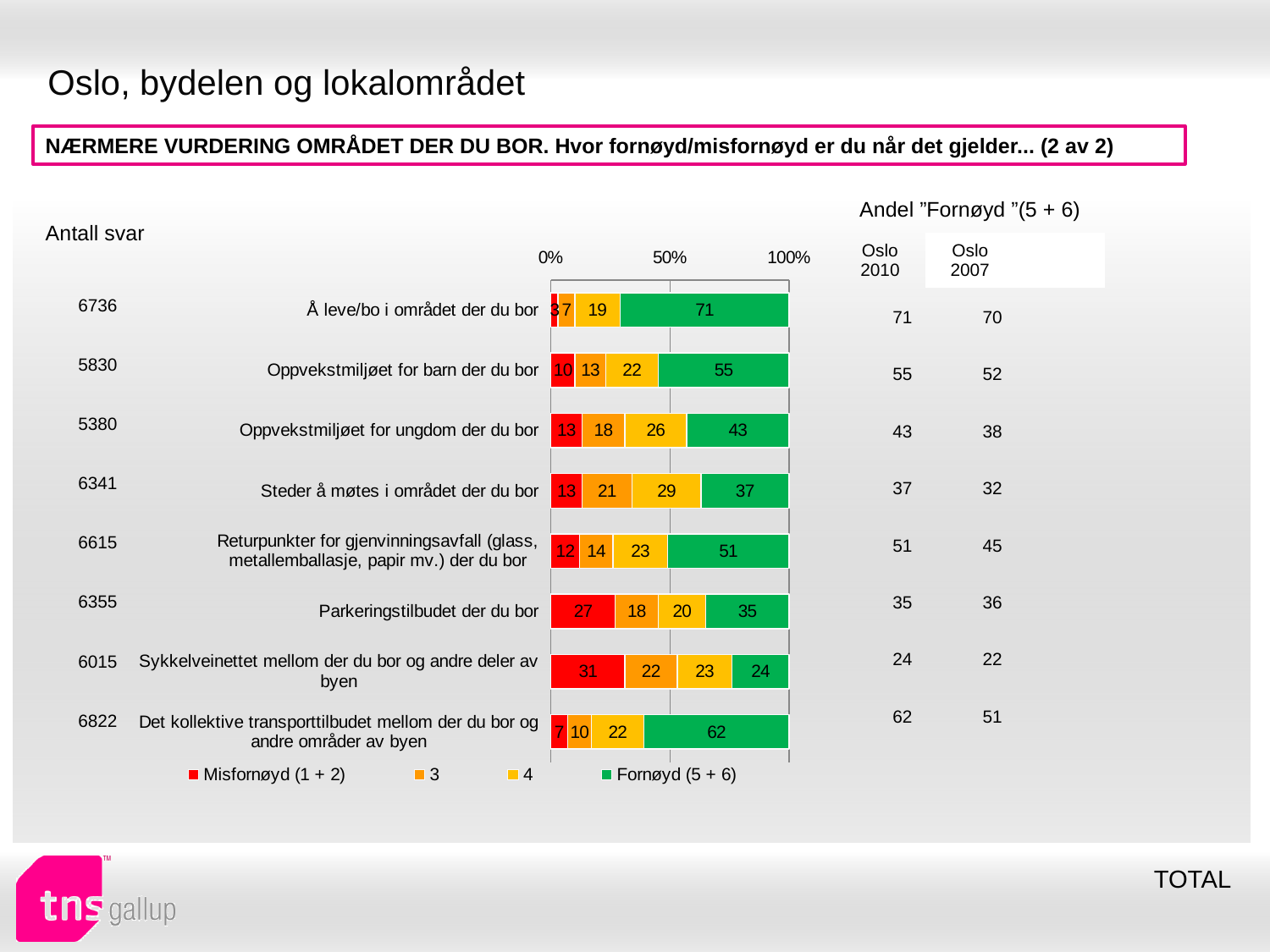
What is the value of the "Fornøyd (5 + 6)" series for "Å leve/bo i området der du bor"? 71 How many categories are shown in the chart? 8 What is the value of the "Misfornøyd (1 + 2)" series for "Sykkelveinettet mellom der du bor og andre deler av byen"? 31 What is the difference between the "Fornøyd (5 + 6)" values for "Oppvekstmiljøet for barn der du bor" and "Oppvekstmiljøet for ungdom der du bor"? 12 How many series does the legend list? 4 What is the value of the "3" series for "Parkeringstilbudet der du bor"? 18 Which category has the lowest value for the "Fornøyd (5 + 6)" series? Sykkelveinettet mellom der du bor og andre deler av byen Which has a larger "Misfornøyd (1 + 2)" value: "Parkeringstilbudet der du bor" or "Returpunkter for gjenvinningsavfall (glass, metallemballasje, papir mv.) der du bor"? Parkeringstilbudet der du bor Which category has the highest value for the "Fornøyd (5 + 6)" series? Å leve/bo i området der du bor What is the total of the stacked bar for "Det kollektive transporttilbudet mellom der du bor og andre områder av byen"? 101 What is the value of the "4" series for "Steder å møtes i området der du bor"? 29 What kind of chart is shown on the slide? Stacked bar chart